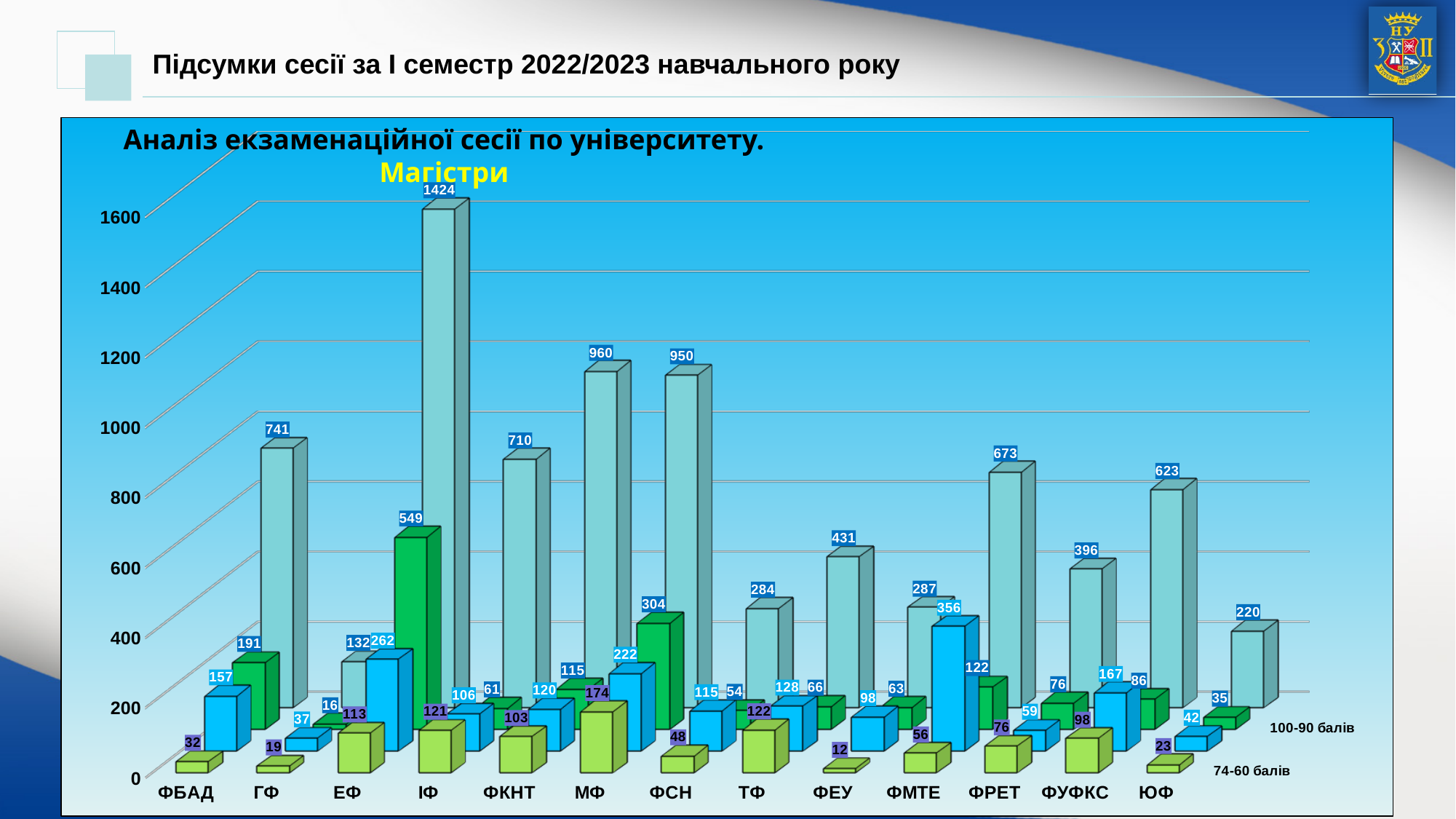
What is the 74-60 балів value for ФБАД? 32 What is the value of the smallest light-green (74-60 балів) bar in the chart? 12 What is the value of the smallest green (100-90 балів) bar in the chart? 16 What is the value of the tallest light-green (74-60 балів) bar in the chart? 174 What is the value of the tallest green (100-90 балів) bar in the chart? 549 What kind of chart is shown on the slide? bar chart Which group of students does the yellow subtitle above the chart say the data is for? Магістри Which faculty has the larger 74-60 балів value, МФ or ФКНТ? МФ What is the title printed inside the chart area? Аналіз екзаменаційної сесії по університету. What is the highest value labelled on any bar in the chart? 1424 How many faculties (categories) are shown along the x axis of the chart? 13 What is the 74-60 балів value for ЮФ? 23